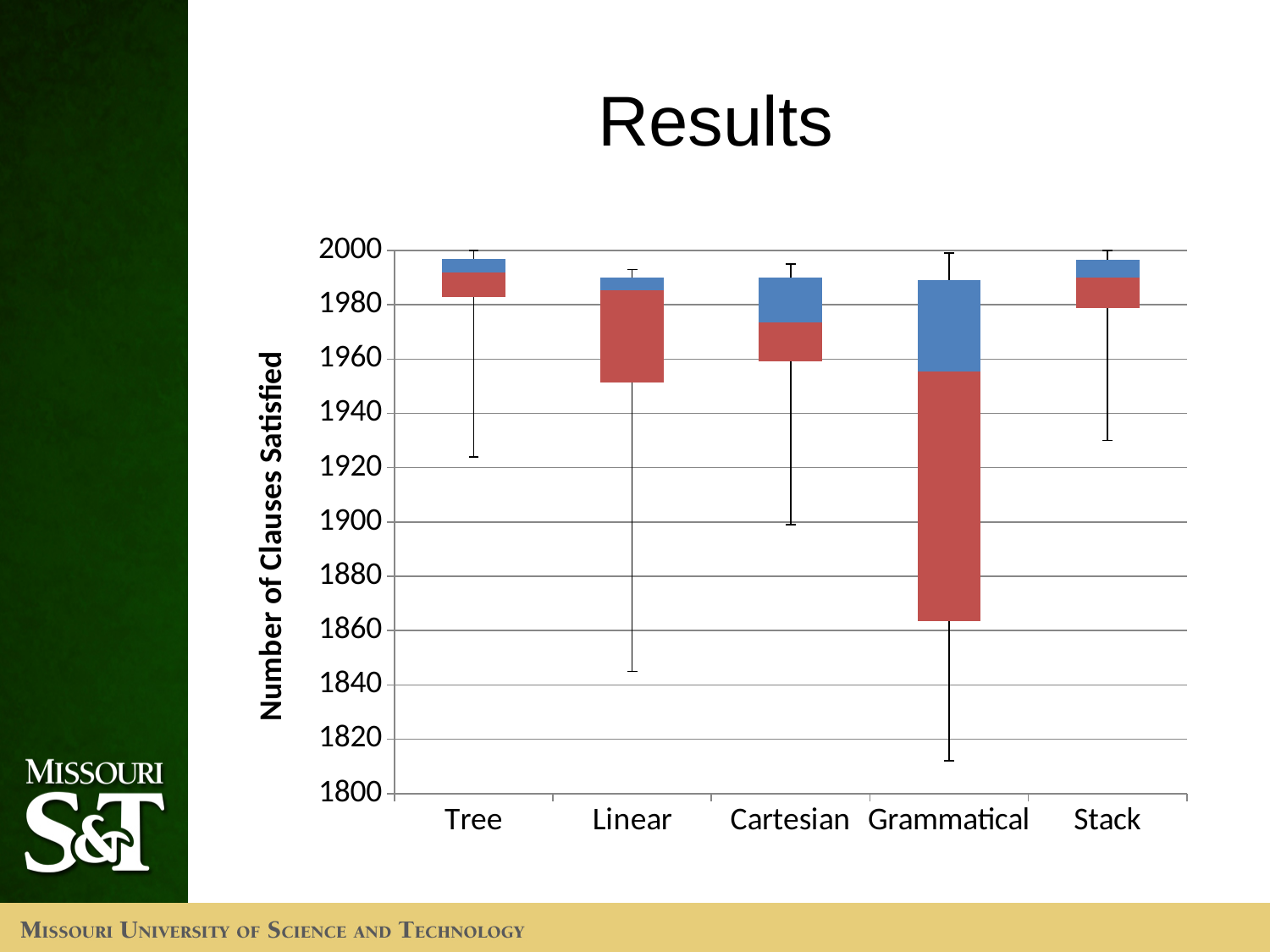
Is the bottom of the box for Linear greater or less than 1940? greater Which category has the tallest box (largest spread between the top and bottom of its box)? Grammatical Which category has the lowest point reached by its lower whisker? Grammatical Is the bottom of the lower whisker for Linear greater or less than 1840? greater How many categories are shown on the x axis of the chart? 5 What is the title of the y axis of the chart? Number of Clauses Satisfied Is the bottom of the lower whisker for Grammatical greater or less than 1820? less What is the title of the slide containing the chart? Results What is the maximum value shown on the y axis of the chart? 2000 Which category's lower whisker reaches lower: Tree or Linear? Linear